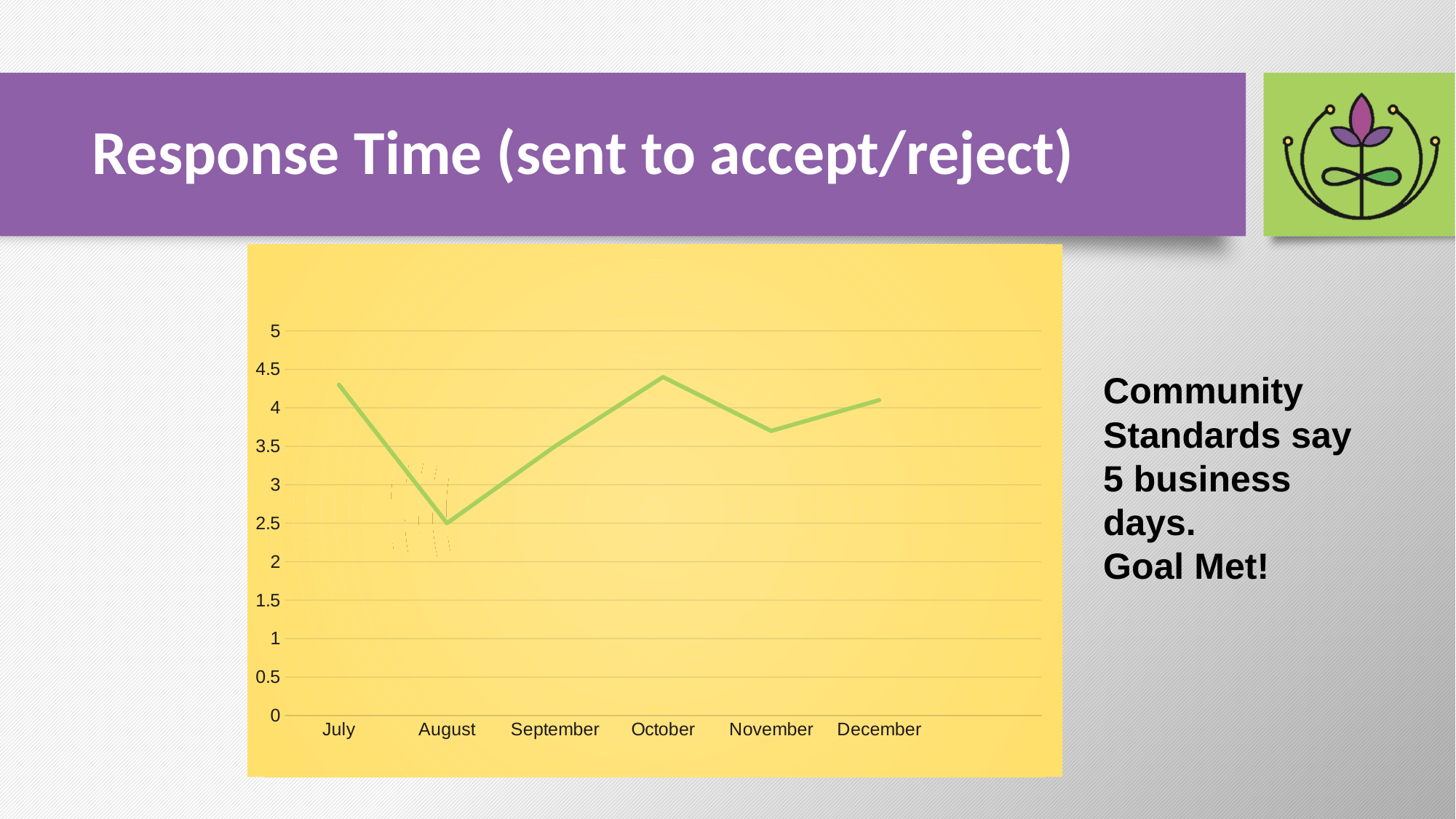
How many months are plotted on the x axis of the chart? 6 Is the value for July greater or less than 4? greater What is the response time value for August? 2.5 What kind of chart is shown on the slide? line chart Does the line rise or fall from July to August? fall Which is larger, the value for November or the value for December? December Is the value for August greater or less than 3? less What is the title of the slide containing the chart? Response Time (sent to accept/reject) Is the value for October greater or less than 4? greater Which is larger, the value for August or the value for October? October Which month has the lowest response time in the chart? August